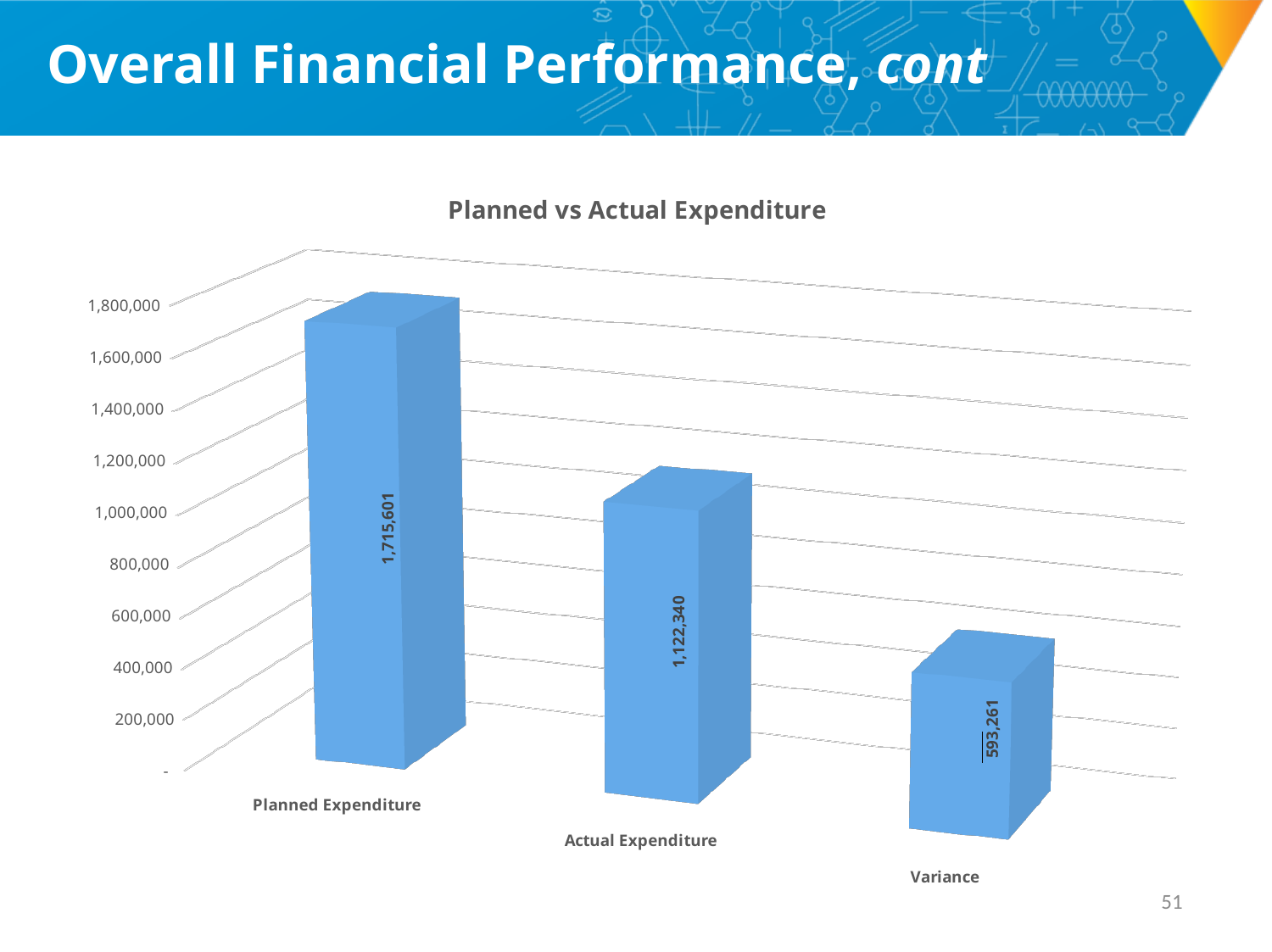
What is the value for Actual Expenditure? 1,122,340 Which category has the lowest value? Variance How many categories are shown in the chart? 3 What is the value for Planned Expenditure? 1,715,601 What is the difference between Planned Expenditure and Actual Expenditure? 593,261 Which is larger, Actual Expenditure or Variance? Actual Expenditure Which category has the highest value? Planned Expenditure Do the values rise or fall from left to right across the categories? Fall Is the value for Actual Expenditure greater or less than 1,000,000? greater What kind of chart is shown on the slide? Bar chart What is the value for Variance? 593,261 What is the title of the chart? Planned vs Actual Expenditure